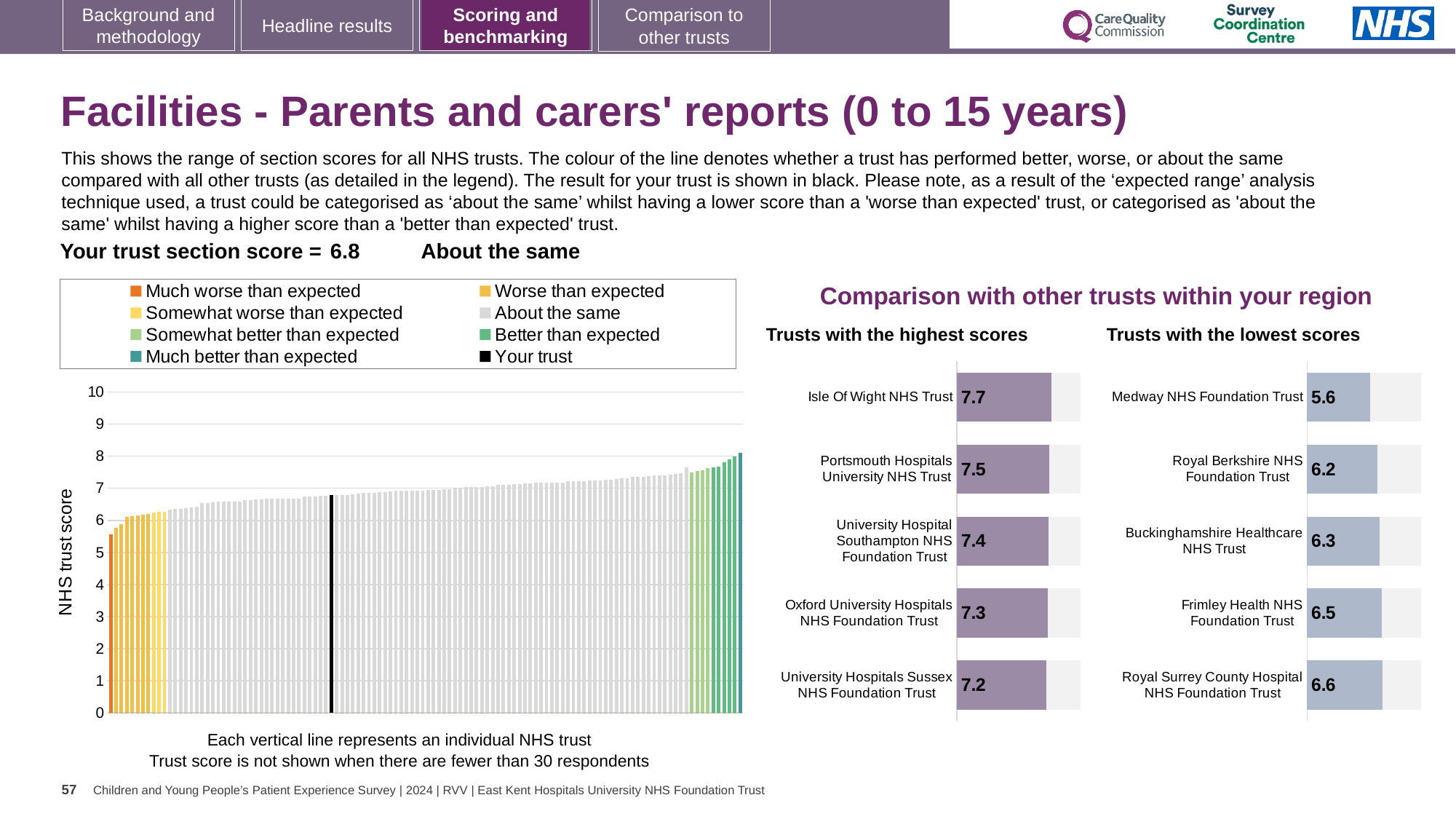
What kind of chart is the large chart on the left showing NHS trust scores? bar chart In the large chart on the left, do the trust scores rise or fall from left to right? rise In the 'Trusts with the lowest scores' chart, how much higher is Royal Surrey County Hospital NHS Foundation Trust's score than Medway NHS Foundation Trust's? 1.0 In the 'Trusts with the lowest scores' chart, what is the score for Medway NHS Foundation Trust? 5.6 In the 'Trusts with the highest scores' chart, which has the larger score: Portsmouth Hospitals University NHS Trust or Oxford University Hospitals NHS Foundation Trust? Portsmouth Hospitals University NHS Trust In the 'Trusts with the highest scores' chart, what is the difference between the scores of Isle Of Wight NHS Trust and University Hospitals Sussex NHS Foundation Trust? 0.5 In the 'Trusts with the highest scores' chart, which trust has the highest score? Isle Of Wight NHS Trust In the 'Trusts with the lowest scores' chart, what is the score for Buckinghamshire Healthcare NHS Trust? 6.3 In the 'Trusts with the lowest scores' chart, which trust has the lowest score? Medway NHS Foundation Trust How many trusts are listed in the 'Trusts with the highest scores' chart? 5 How many entries does the legend of the large chart on the left list? 8 In the 'Trusts with the highest scores' chart, what is the score for Isle Of Wight NHS Trust? 7.7